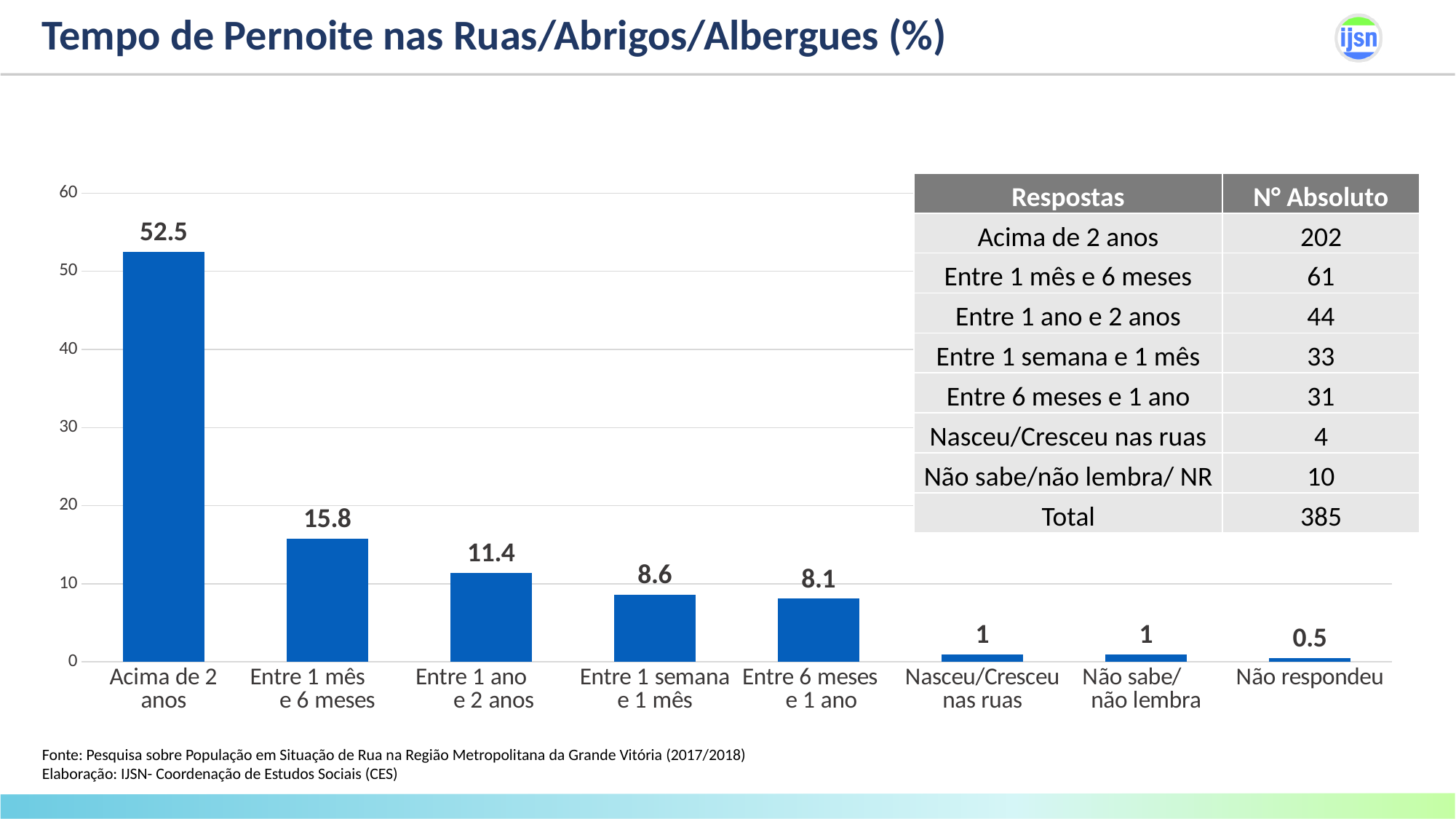
Is the value for "Entre 1 mês e 6 meses" greater or less than 20? less What kind of chart is shown on the slide? bar chart Which category has the highest value? Acima de 2 anos Which category has the lowest value? Não respondeu What is the value for "Entre 6 meses e 1 ano"? 8.1 How many categories are shown on the x axis of the chart? 8 What is the value for "Não respondeu"? 0.5 What is the value for "Entre 1 mês e 6 meses"? 15.8 What is the value for "Acima de 2 anos"? 52.5 Which is larger, the value for "Entre 1 ano e 2 anos" or the value for "Entre 1 semana e 1 mês"? Entre 1 ano e 2 anos What is the difference between the values for "Entre 1 semana e 1 mês" and "Entre 6 meses e 1 ano"? 0.5 What is the difference between the values for "Acima de 2 anos" and "Entre 1 mês e 6 meses"? 36.7